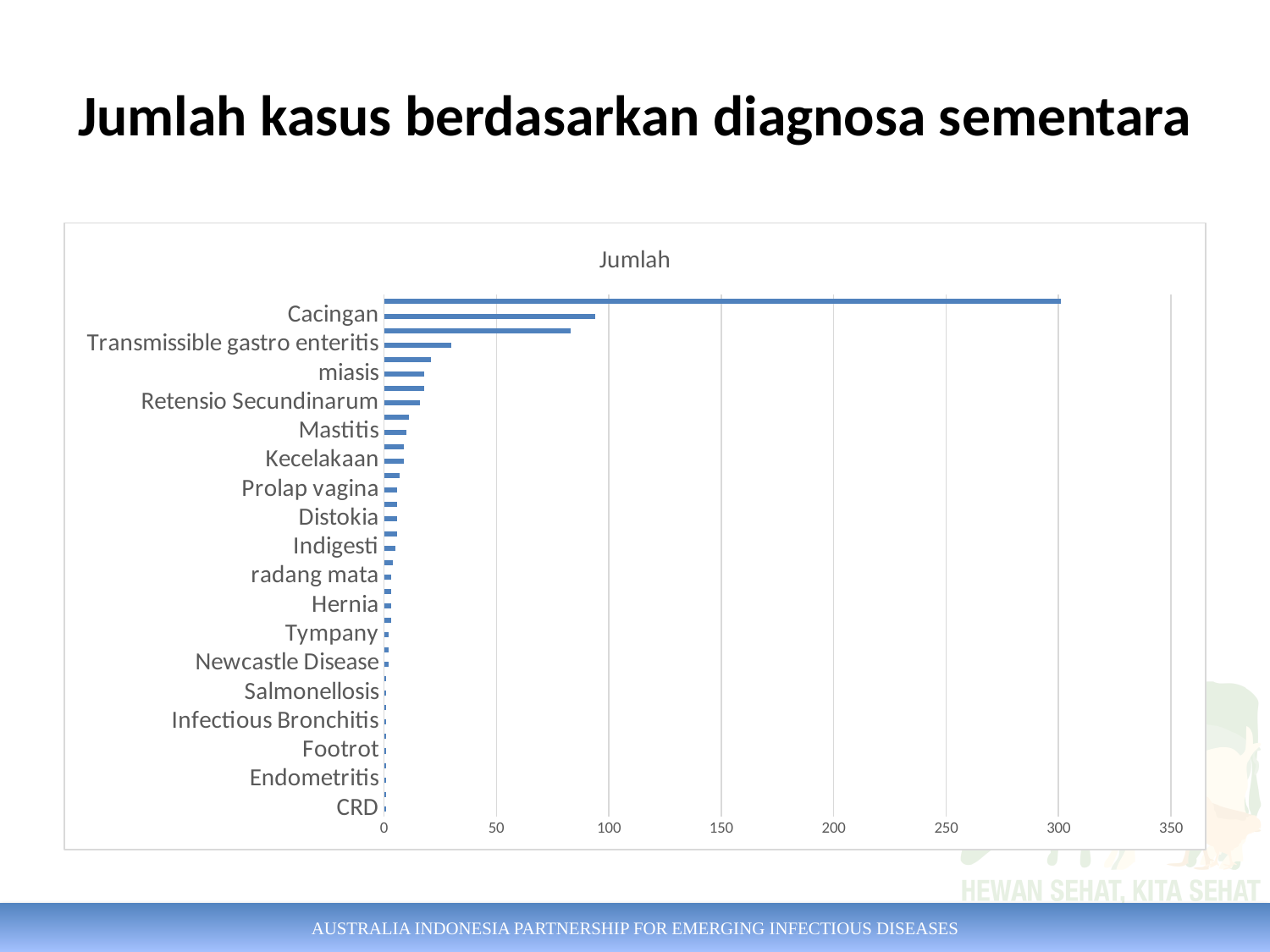
Which has a larger value, Cacingan or Transmissible gastro enteritis? Cacingan What is the title of the slide? Jumlah kasus berdasarkan diagnosa sementara Is the value for Retensio Secundinarum greater or less than 100? less Is the value for miasis greater or less than 50? less What kind of chart is shown on the slide? bar chart Is the value for Mastitis greater or less than 50? less Which has a larger value, Mastitis or Hernia? Mastitis What is the title shown inside the chart area? Jumlah Which has a larger value, Transmissible gastro enteritis or Kecelakaan? Transmissible gastro enteritis Do the bar values increase or decrease going from the top of the chart to the bottom? decrease